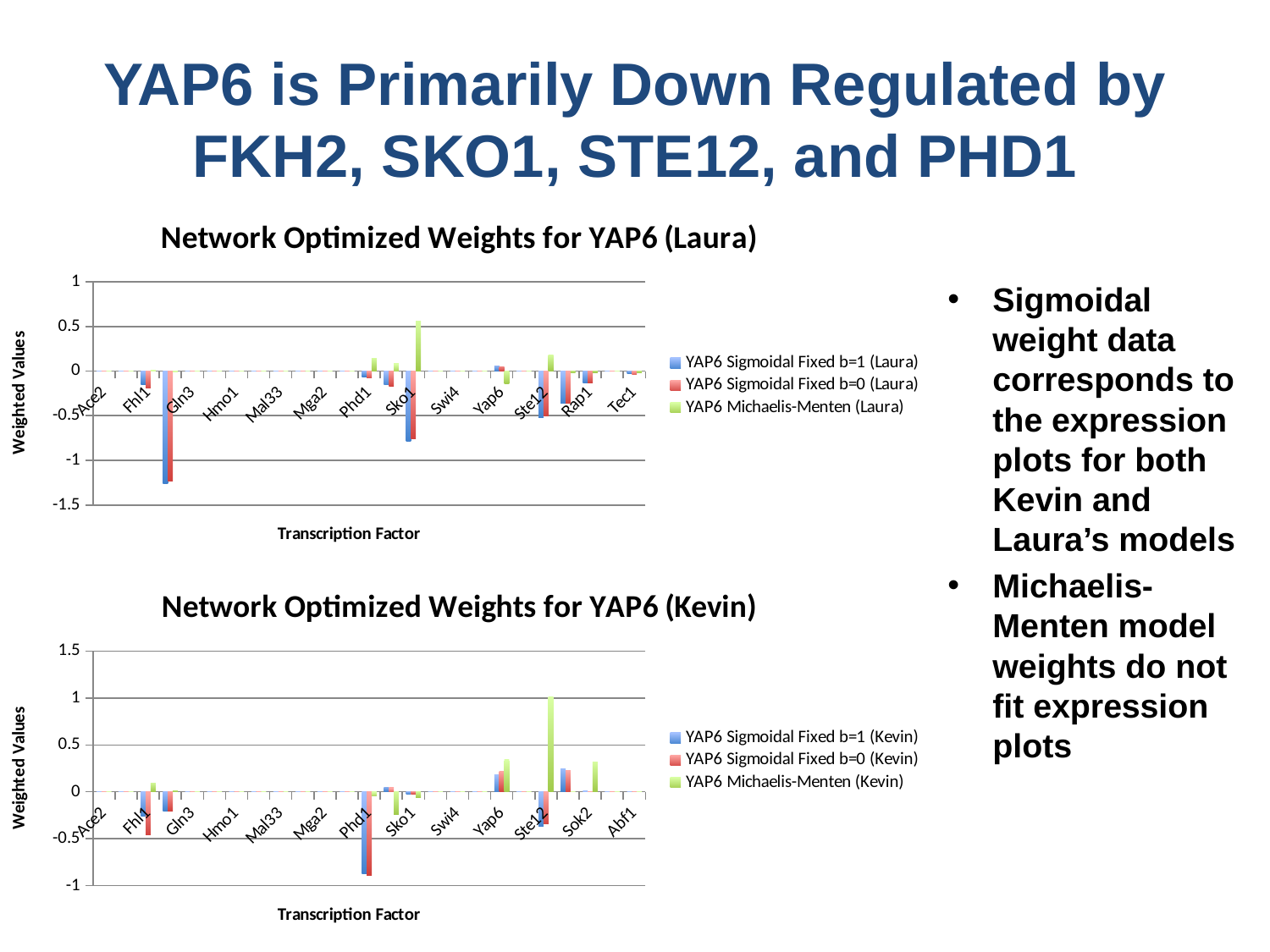
In 'Network Optimized Weights for YAP6 (Kevin)', is the value for Phd1 in the YAP6 Sigmoidal Fixed b=0 (Kevin) series greater or less than -0.5? less In 'Network Optimized Weights for YAP6 (Kevin)', which transcription factor has the highest value for YAP6 Michaelis-Menten (Kevin)? Ste12 What kind of chart is 'Network Optimized Weights for YAP6 (Laura)'? bar chart In 'Network Optimized Weights for YAP6 (Kevin)', which transcription factor has the lowest value for YAP6 Sigmoidal Fixed b=0 (Kevin)? Phd1 In 'Network Optimized Weights for YAP6 (Laura)', which is larger for the YAP6 Sigmoidal Fixed b=1 (Laura) series, the value for Gln3 or the value for Sko1? Gln3 In 'Network Optimized Weights for YAP6 (Kevin)', is the value for Ste12 in the YAP6 Michaelis-Menten (Kevin) series greater or less than 0.5? greater How many series does the legend of 'Network Optimized Weights for YAP6 (Kevin)' list? 3 In 'Network Optimized Weights for YAP6 (Laura)', is the value for Gln3 in the YAP6 Sigmoidal Fixed b=1 (Laura) series greater or less than -1? greater In 'Network Optimized Weights for YAP6 (Laura)', which transcription factor has the highest value for YAP6 Michaelis-Menten (Laura)? Sko1 What is the x-axis title of 'Network Optimized Weights for YAP6 (Kevin)'? Transcription Factor